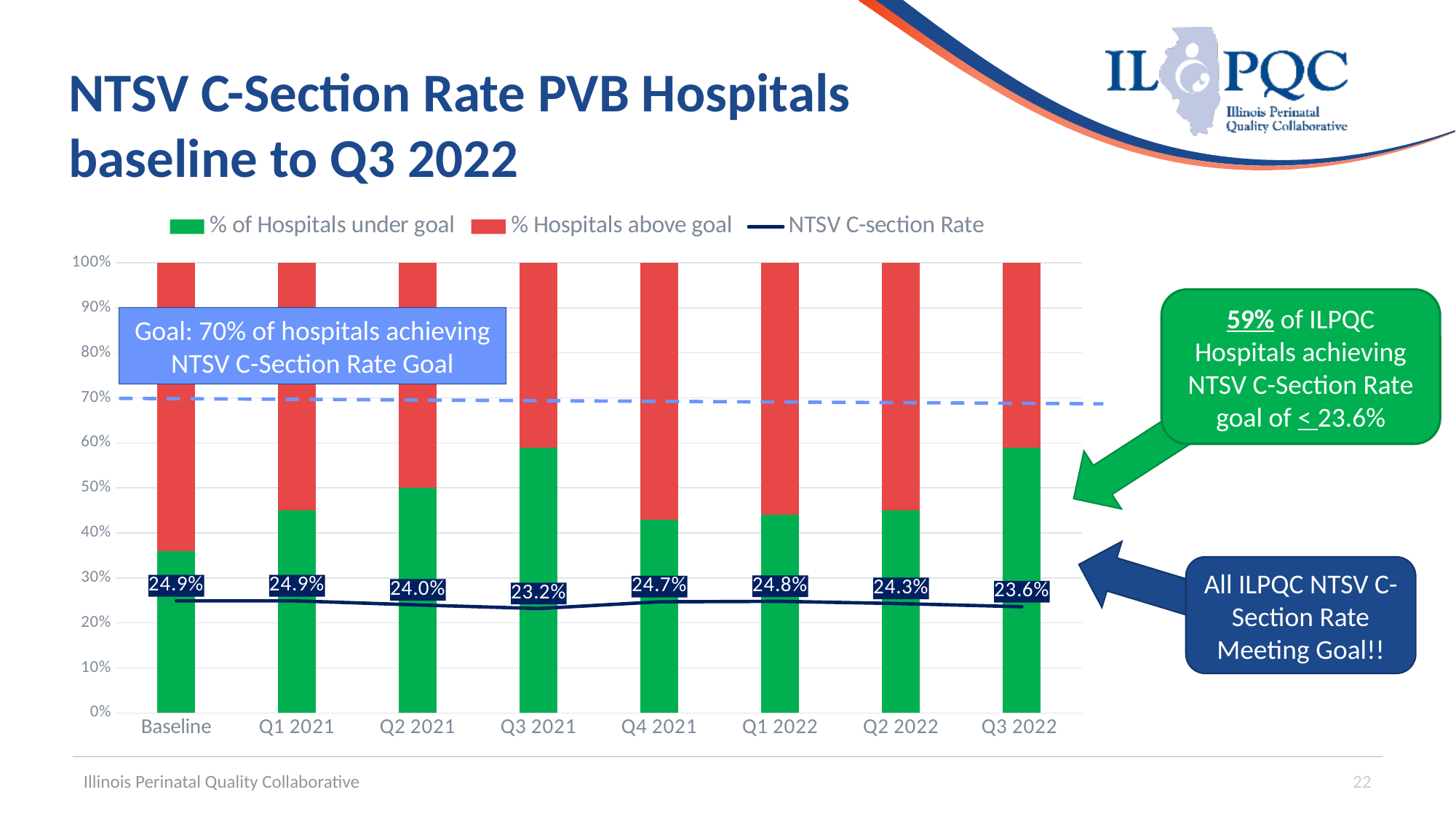
Which has the higher NTSV C-section Rate, Q4 2021 or Q2 2022? Q4 2021 What is the NTSV C-section Rate at Baseline? 24.9% How many series does the chart legend list? 3 What is the NTSV C-section Rate for Q3 2022? 23.6% Is the % of Hospitals under goal at Baseline greater or less than 40%? less How many time periods are shown on the x axis of the chart? 8 Is the % of Hospitals under goal in Q3 2021 greater or less than 50%? greater What is the NTSV C-section Rate for Q3 2021? 23.2% Which period has the lowest NTSV C-section Rate? Q3 2021 Does the NTSV C-section Rate rise or fall from Q1 2022 to Q3 2022? fall By how many percentage points did the NTSV C-section Rate fall from Baseline to Q3 2022? 1.3 percentage points What kind of chart is shown on the slide? a combination stacked bar and line chart